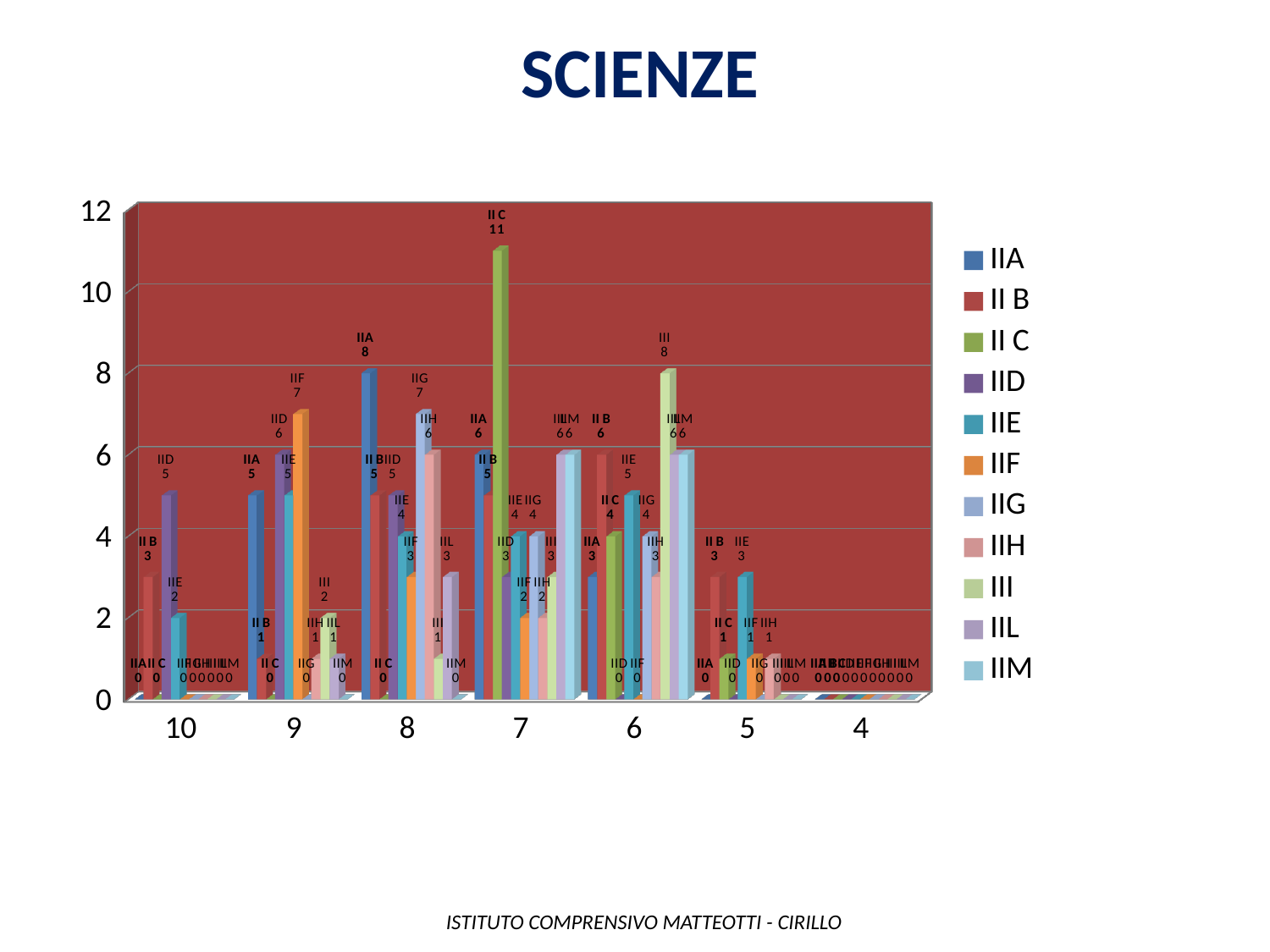
What is the difference between the values for IIA and II B in category 8? 3 How many categories are shown on the x axis? 7 What is the value for IIA in category 8? 8 What is the value for III in category 6? 8 Which series has the highest value in category 6? III Is the value for II C in category 7 greater or less than 10? greater Which series has the highest value in category 7? II C What is the value for II C in category 7? 11 How many series does the legend list? 11 What is the title of the chart? SCIENZE What kind of chart is shown on the slide? bar chart What is the value for IIF in category 9? 7